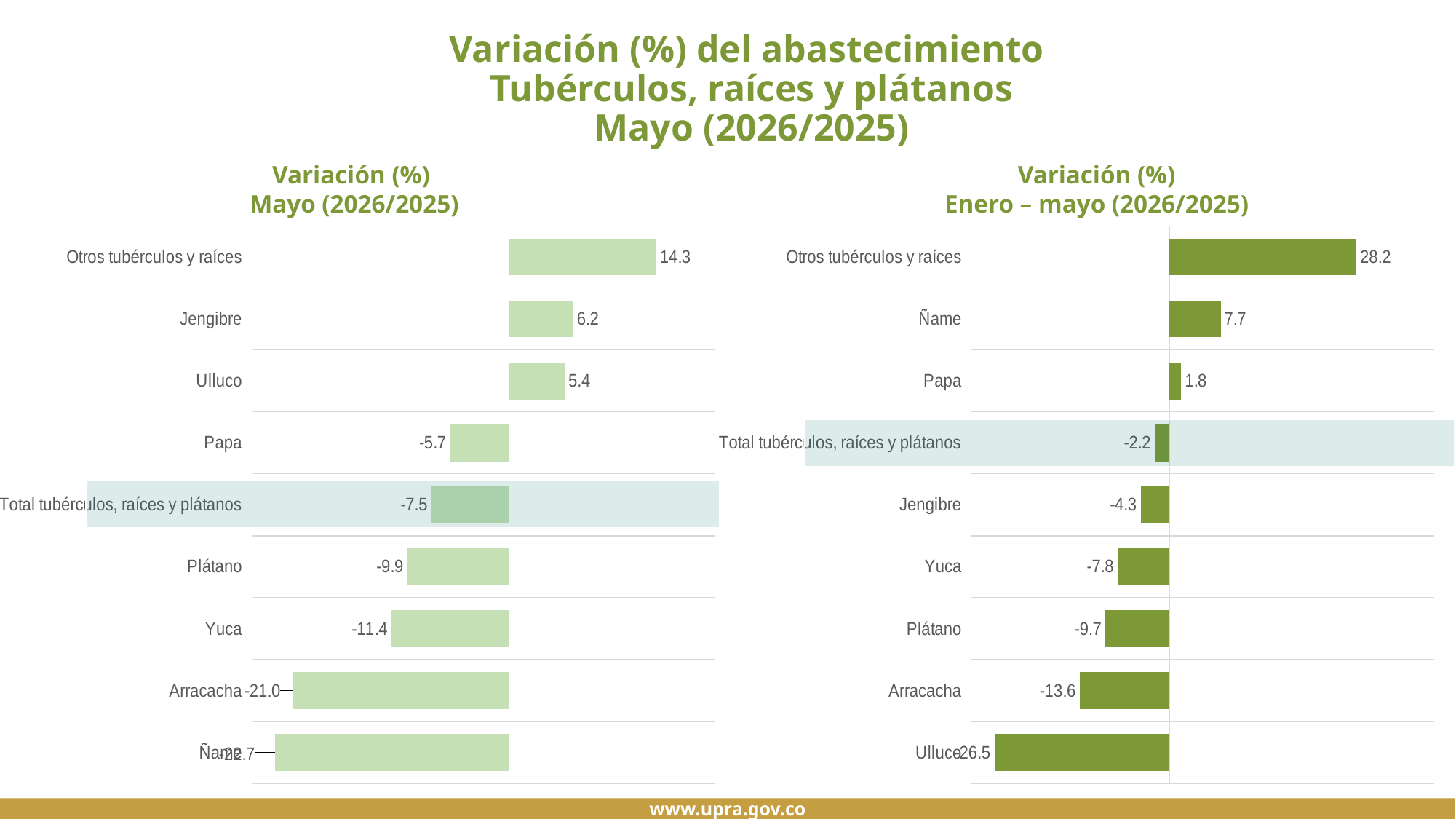
In the left chart (Variación (%) Mayo (2026/2025)), what is the value for Otros tubérculos y raíces? 14.3 In the right chart (Variación (%) Enero – mayo (2026/2025)), what is the value for Ñame? 7.7 In the right chart (Variación (%) Enero – mayo (2026/2025)), which is larger, the value for Papa or the value for Jengibre? Papa How many categories are shown in the left chart (Variación (%) Mayo (2026/2025))? 9 What type of chart is the right chart (Variación (%) Enero – mayo (2026/2025))? Bar chart In the right chart (Variación (%) Enero – mayo (2026/2025)), which category has the highest value? Otros tubérculos y raíces In the left chart (Variación (%) Mayo (2026/2025)), what is the value for Yuca? -11.4 In the left chart (Variación (%) Mayo (2026/2025)), which category has the lowest value? Ñame In the right chart (Variación (%) Enero – mayo (2026/2025)), what is the value for Arracacha? -13.6 In the right chart (Variación (%) Enero – mayo (2026/2025)), which category has the lowest value? Ulluco In the left chart (Variación (%) Mayo (2026/2025)), what is the difference between the values for Jengibre and Ulluco? 0.8 In the left chart (Variación (%) Mayo (2026/2025)), what is the value for Total tubérculos, raíces y plátanos? -7.5